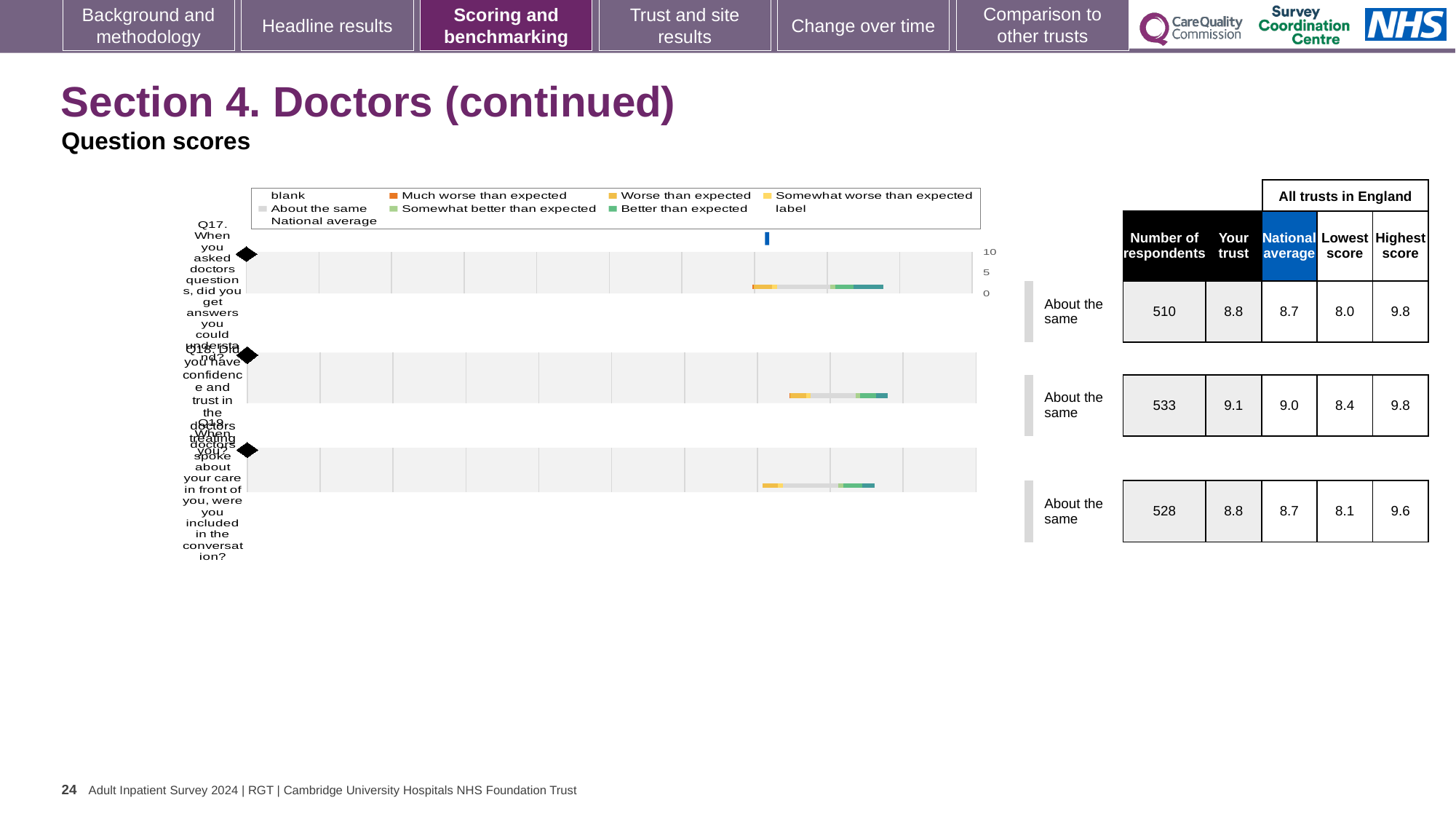
What kind of chart is used to show the question scores for Q17, Q18 and Q19? bar chart In the table beside the chart, is the highest score for Q17 larger or smaller than the highest score for Q19? larger How many entries does the legend of the question scores chart list? 9 According to the table beside the chart, how many respondents answered Q18 (Did you have confidence and trust in the doctors treating you)? 533 How many questions (bars) are plotted in the question scores chart? 3 What benchmark category is shown next to each of the three question bars? About the same According to the table beside the chart, what is the 'Your trust' score for Q17 (When you asked doctors questions, did you get answers you could understand)? 8.8 According to the table beside the chart, what is the national average score for Q19 (When doctors spoke about your care in front of you, were you included in the conversation)? 8.7 Which of the three questions has the highest 'Your trust' score in the table beside the chart? Q18 According to the table beside the chart, what is the lowest score among all trusts in England for Q18? 8.4 What is the difference between the 'Your trust' score and the national average for Q18 in the table beside the chart? 0.1 What is the highest value shown on the score axis of the question scores chart? 10